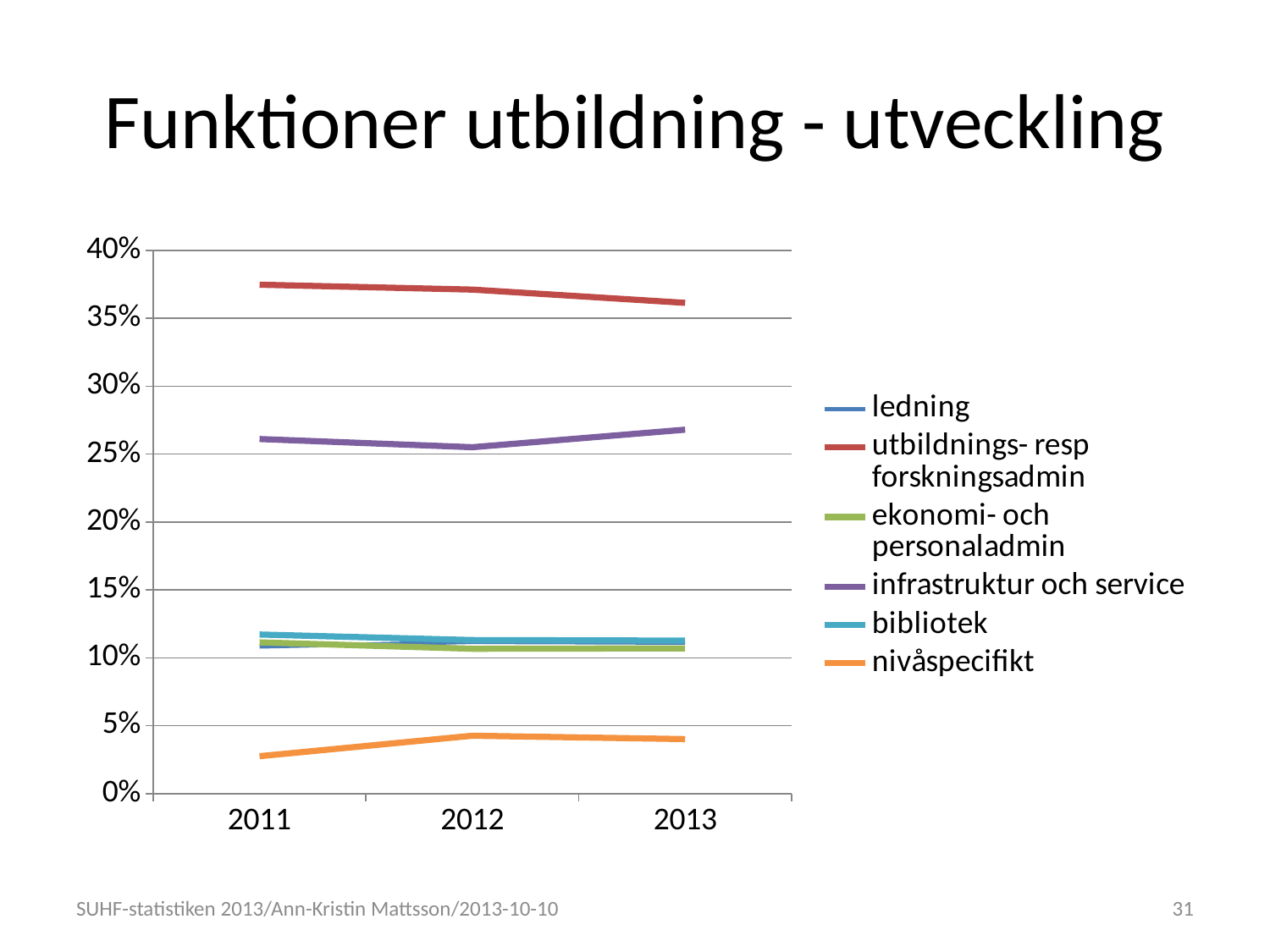
How many years are shown on the x axis? 3 Is the value for utbildnings- resp forskningsadmin in 2011 greater or less than 35%? greater Which is larger in 2013, infrastruktur och service or bibliotek? infrastruktur och service Does the value for nivåspecifikt rise or fall from 2011 to 2012? rise Which series has the highest value in 2013? utbildnings- resp forskningsadmin What is the title of the slide? Funktioner utbildning - utveckling Does the value for utbildnings- resp forskningsadmin rise or fall from 2011 to 2013? fall How many series does the legend list? 6 Which series has the lowest value in 2011? nivåspecifikt Is the value for infrastruktur och service in 2013 greater or less than 25%? greater Is the value for nivåspecifikt in 2011 greater or less than 5%? less What kind of chart is shown on the slide? line chart